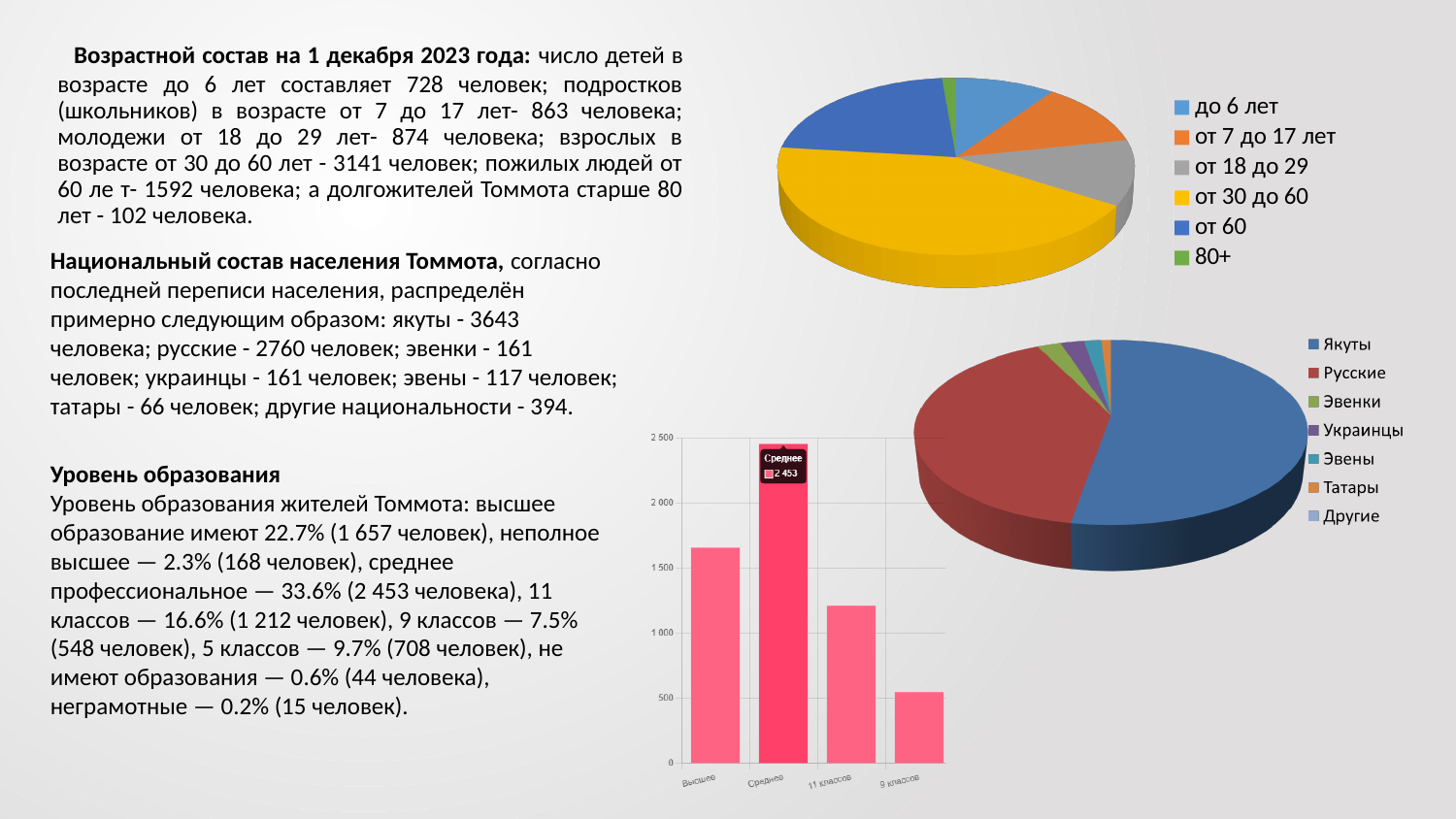
In the top-right age pie chart, which age group has the smallest slice? 80+ In the bottom bar chart, is the value for Высшее greater or less than 1 500? greater In the bottom bar chart, which category has the lowest bar? 9 классов In the bottom bar chart, is the value for 9 классов greater or less than 1 000? less In the bottom bar chart, is the value for 11 классов greater or less than 1 500? less In the top-right age pie chart, which age group has the largest slice? от 30 до 60 In the bottom bar chart, what value is shown in the label for Среднее? 2 453 In the bottom bar chart, which category has the highest bar? Среднее How many bars are in the bottom bar chart? 4 In the middle-right nationality pie chart, which nationality has the largest slice? Якуты What kind of chart is the bottom chart showing education levels? bar chart What kind of chart is the top-right chart with the age groups legend? pie chart